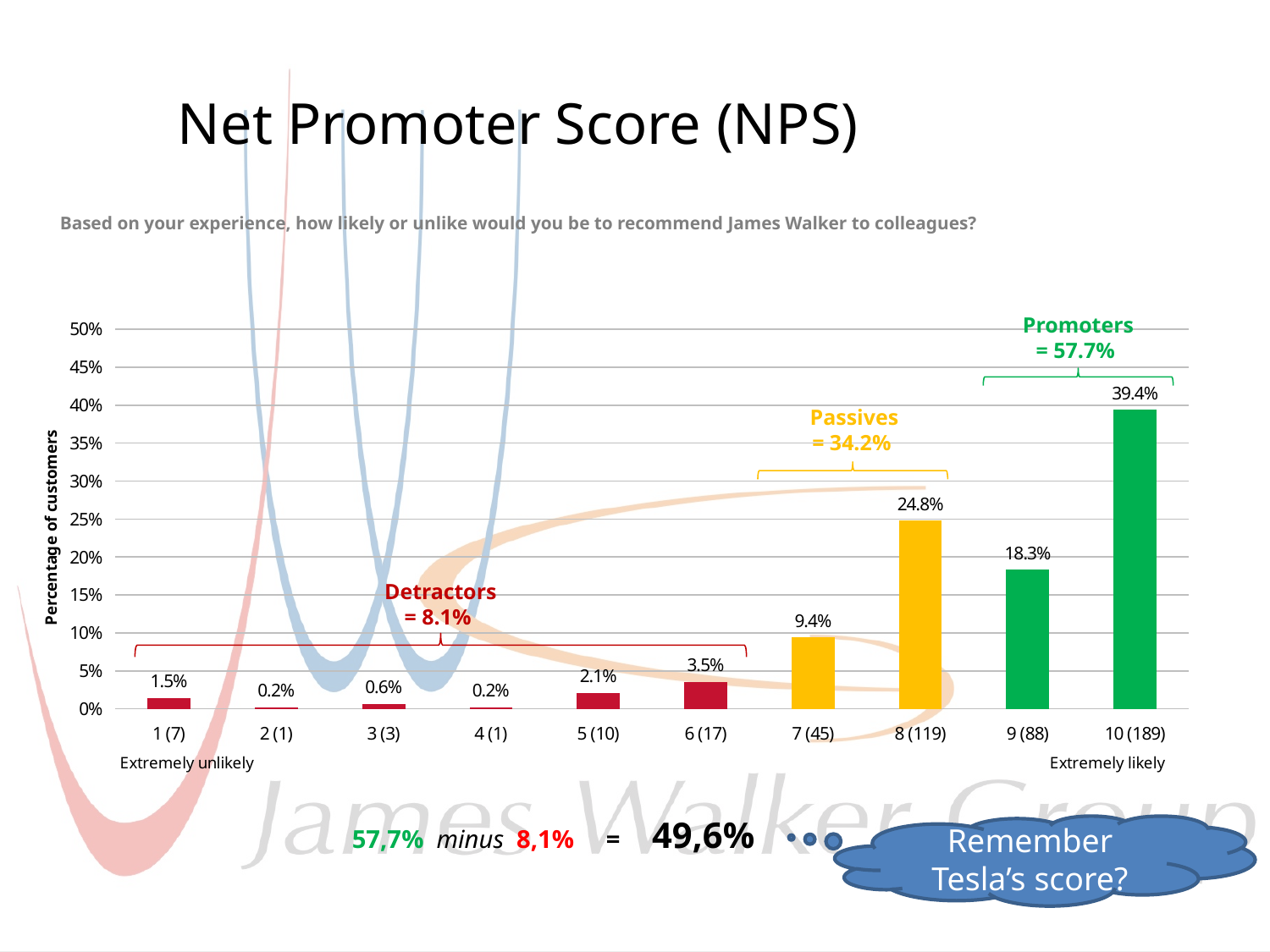
What is the label of the y axis? Percentage of customers How many score categories are shown on the x axis? 10 What kind of chart is shown on the slide? Bar chart What percentage of customers gave a score of 7 (45)? 9.4% What percentage of customers gave a score of 10 (189)? 39.4% Which score category has the highest percentage of customers? 10 (189) Which has a larger percentage of customers, score 8 (119) or score 9 (88)? 8 (119) What percentage of customers gave a score of 8 (119)? 24.8% Is the value for score 7 (45) greater or less than 10%? less What is the total percentage labelled for the Promoters group? 57.7% What is the difference in percentage of customers between score 10 (189) and score 9 (88)? 21.1% What percentage of customers gave a score of 1 (7)? 1.5%